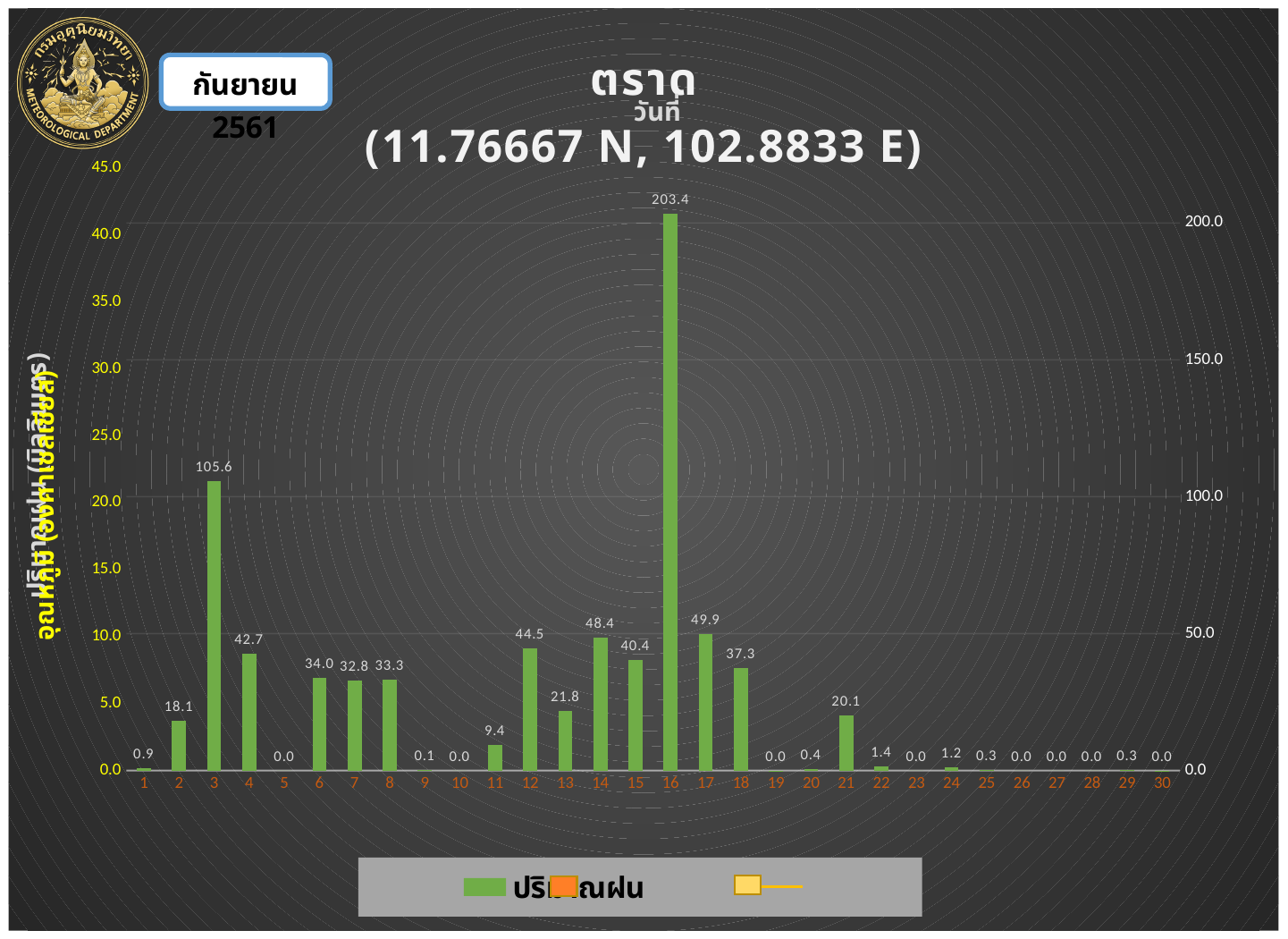
Which day has the highest value? 16 How many days are shown on the x axis? 30 What is the difference between the values for day 16 and day 3? 97.8 What coordinates are given in the chart title? (11.76667 N, 102.8833 E) What kind of chart is shown? bar chart What is the value for day 3? 105.6 Which is larger, the value for day 4 or the value for day 13? day 4 What is the difference between the values for day 17 and day 18? 12.6 What is the value for day 12? 44.5 What is the value for day 16? 203.4 Which is larger, the value for day 14 or the value for day 15? day 14 What is the value for day 21? 20.1